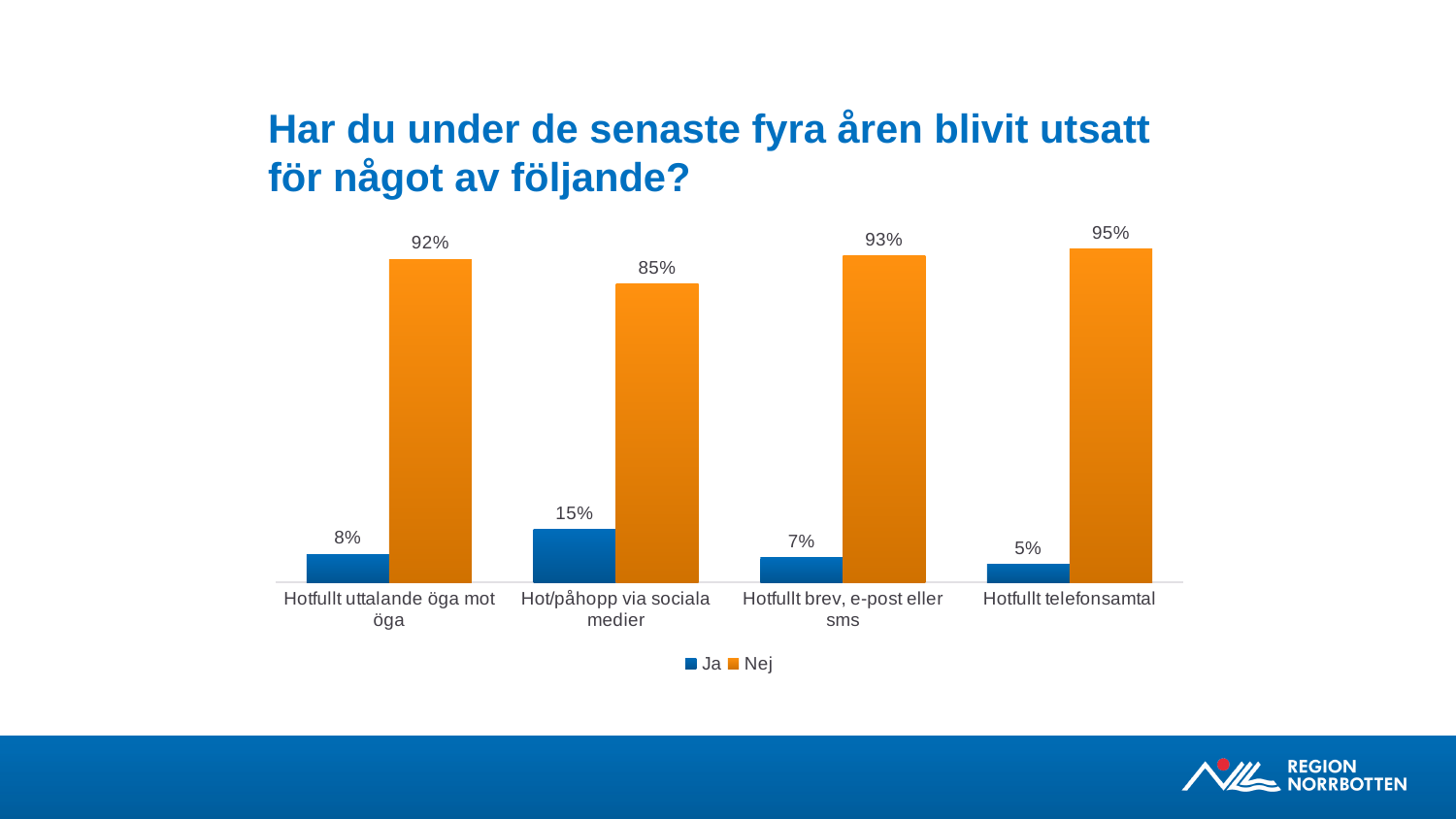
What are the two series listed in the legend? Ja and Nej What colour are the "Nej" bars? Orange What kind of chart is shown on the slide? Bar chart What is the "Ja" value for "Hot/påhopp via sociala medier"? 15% What is the "Ja" value for "Hotfullt brev, e-post eller sms"? 7% What is the "Nej" value for "Hotfullt telefonsamtal"? 95% How many categories are shown on the x axis? 4 Which category has the lowest "Nej" value? Hot/påhopp via sociala medier What is the difference between the "Nej" and "Ja" values for "Hotfullt uttalande öga mot öga"? 84% Which category has the highest "Ja" value? Hot/påhopp via sociala medier How many series does the legend list? 2 Which is larger: the "Ja" value for "Hotfullt uttalande öga mot öga" or the "Ja" value for "Hotfullt telefonsamtal"? Hotfullt uttalande öga mot öga